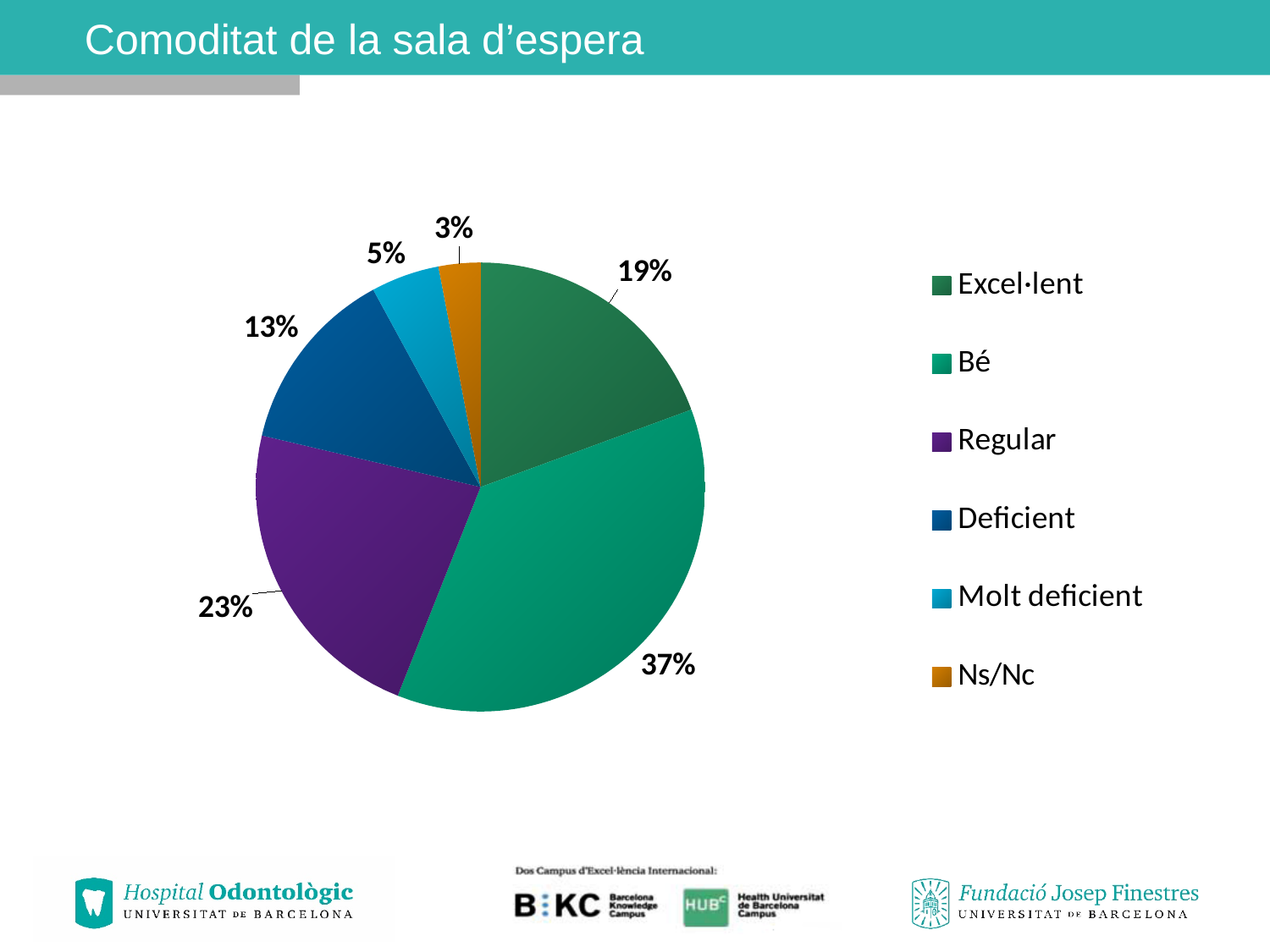
Which category has the smallest slice of the pie? Ns/Nc How many categories does the legend list? 6 Which is larger, the slice for Excel·lent or the slice for Deficient? Excel·lent Which category has the largest slice of the pie? Bé What percentage of the pie corresponds to Excel·lent? 19% What percentage of the pie corresponds to Deficient? 13% What is the title of the slide containing the chart? Comoditat de la sala d'espera What kind of chart is shown on the slide? pie chart What percentage of the pie corresponds to Ns/Nc? 3% What percentage of the pie corresponds to Regular? 23% What is the difference in percentage points between Bé and Regular? 14 What percentage of the pie corresponds to Bé? 37%